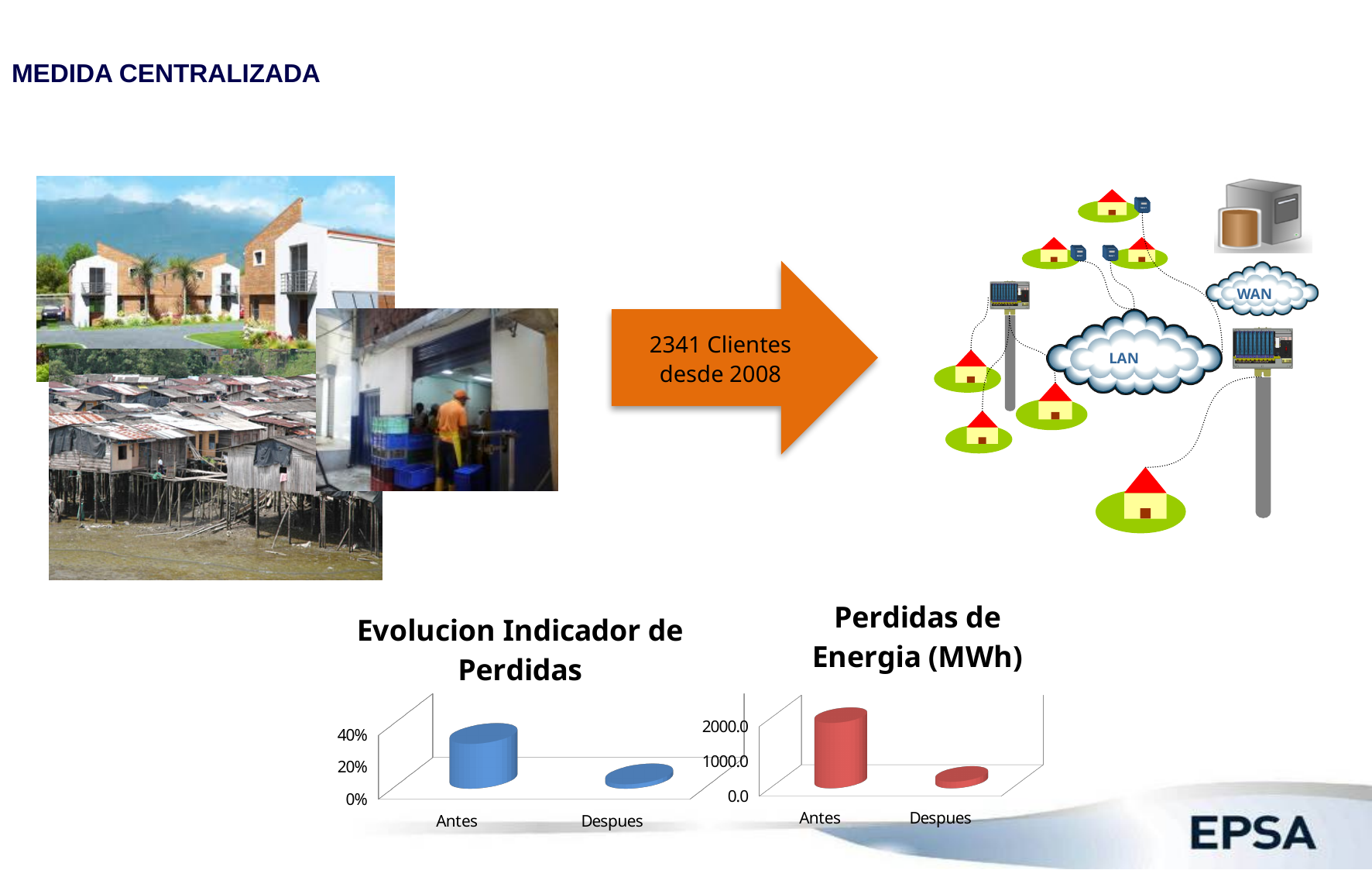
In the 'Evolucion Indicador de Perdidas' chart, which category has the lower value? Despues In the 'Evolucion Indicador de Perdidas' chart, how many categories are shown on the x axis? 2 What kind of chart is 'Evolucion Indicador de Perdidas'? Bar chart In the 'Perdidas de Energia (MWh)' chart, is the value for Antes larger or smaller than the value for Despues? Larger In the 'Perdidas de Energia (MWh)' chart, which category has the higher value? Antes In the 'Evolucion Indicador de Perdidas' chart, is the value for Antes greater or less than 20%? greater In the 'Perdidas de Energia (MWh)' chart, do the values rise or fall from Antes to Despues? Fall In the 'Perdidas de Energia (MWh)' chart, is the value for Despues greater or less than 1000.0? less In the 'Perdidas de Energia (MWh)' chart, is the value for Antes greater or less than 1000.0? greater What colour are the bars in the 'Perdidas de Energia (MWh)' chart? Red In the 'Evolucion Indicador de Perdidas' chart, which category has the higher value? Antes